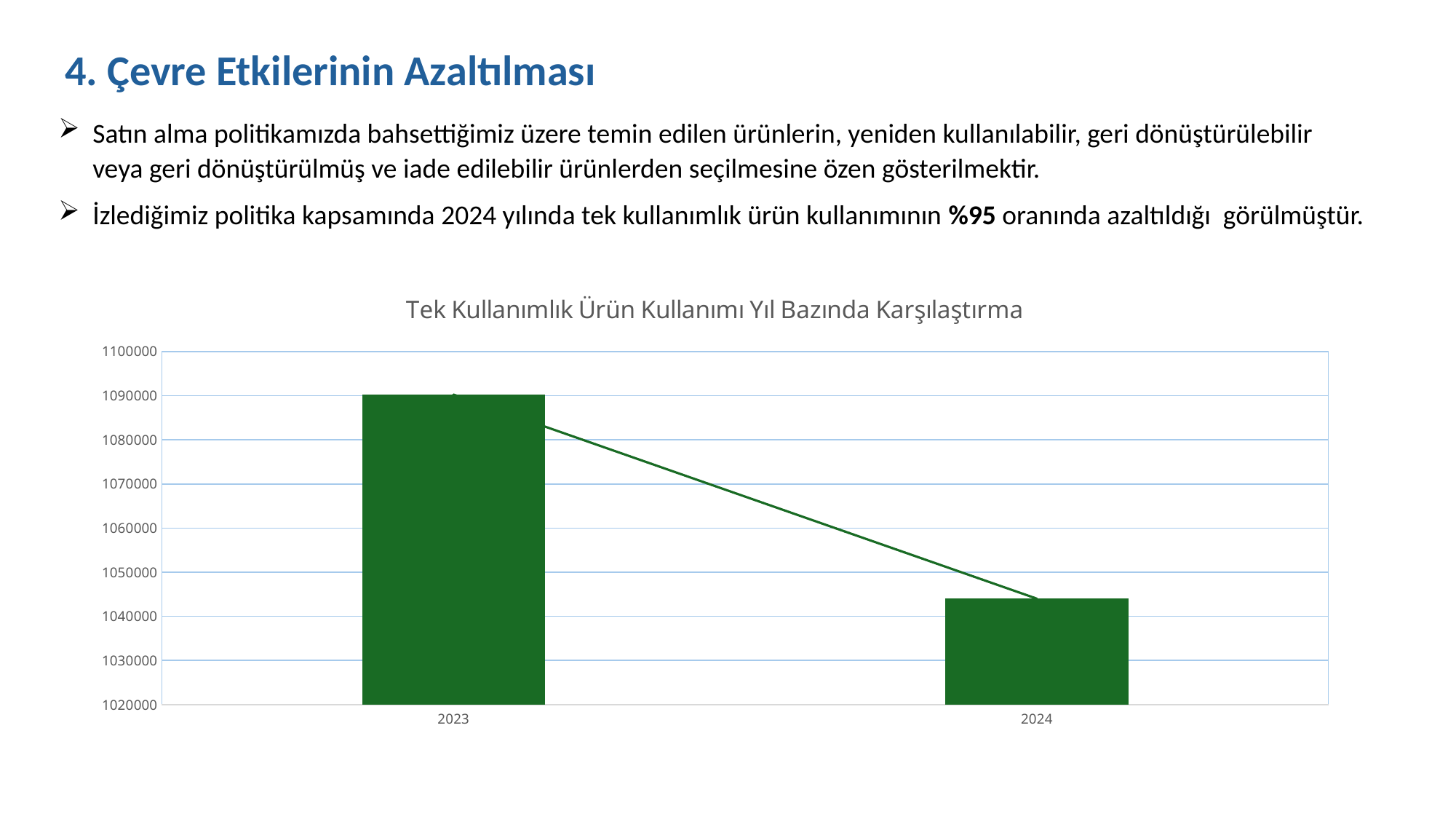
What is the title of the chart? Tek Kullanımlık Ürün Kullanımı Yıl Bazında Karşılaştırma How many years (categories) are shown on the x axis of the chart? 2 Is the value for 2024 greater or less than 1040000? greater Which year has the highest value in the chart? 2023 Do the values rise or fall from 2023 to 2024? fall Is the value for 2023 greater or less than 1080000? greater What is the lowest value shown on the vertical axis of the chart? 1020000 What kind of chart is shown on the slide? bar chart Is the value for 2024 greater or less than 1050000? less Which year has the lowest value in the chart? 2024 Which is larger, the value for 2023 or the value for 2024? 2023